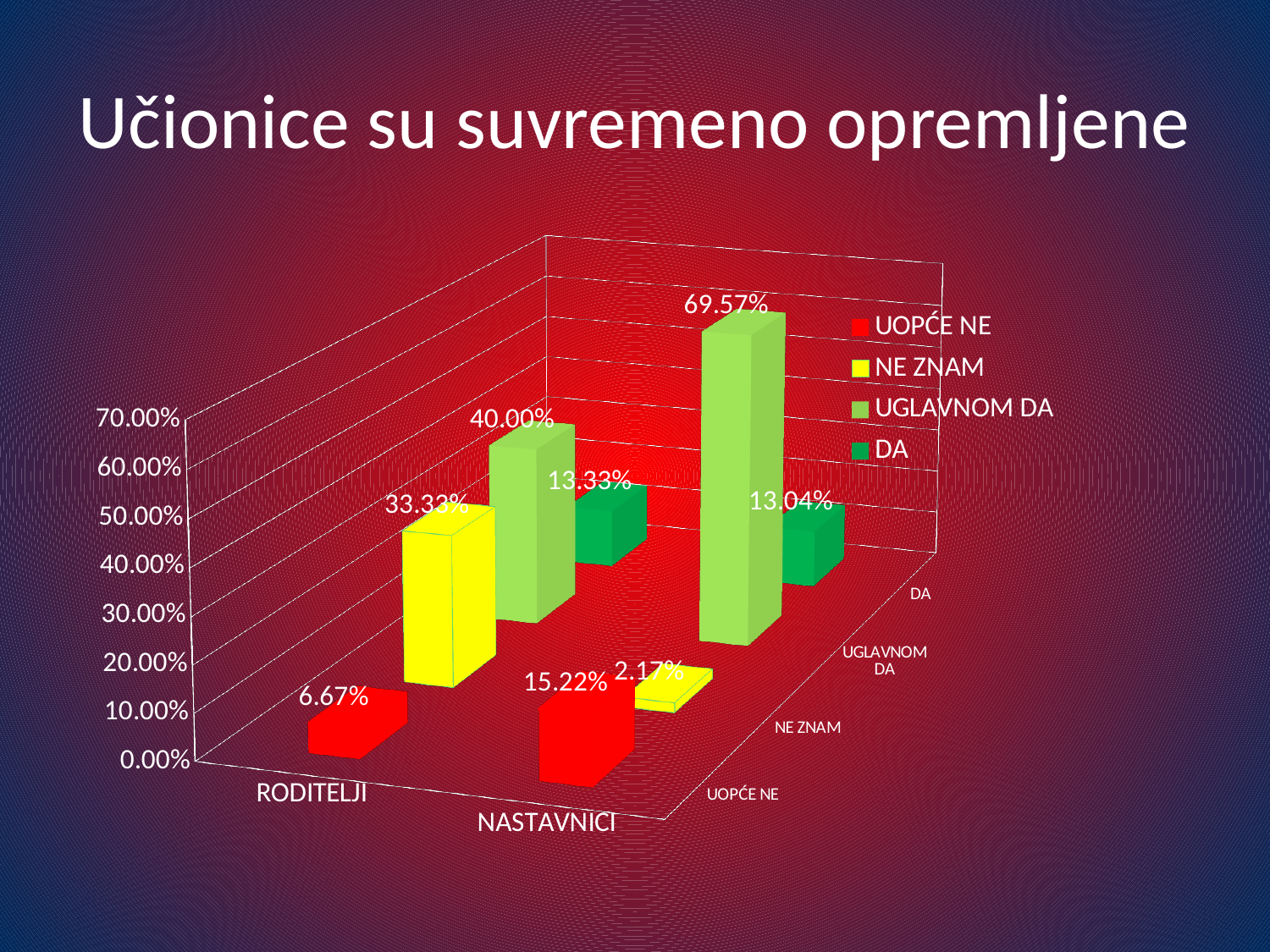
How many categories are shown on the x axis? 2 Which series has the highest value for NASTAVNICI? UGLAVNOM DA Which is larger: NE ZNAM for RODITELJI or NE ZNAM for NASTAVNICI? NE ZNAM for RODITELJI What is the value for UOPĆE NE for NASTAVNICI? 15.22% What kind of chart is shown on the slide? Bar chart What is the value for NE ZNAM for RODITELJI? 33.33% What is the difference between the UGLAVNOM DA values for NASTAVNICI and RODITELJI? 29.57% What is the value for UGLAVNOM DA for NASTAVNICI? 69.57% Which series has the lowest value for RODITELJI? UOPĆE NE What is the value for DA for RODITELJI? 13.33% What is the title of the slide? Učionice su suvremeno opremljene How many series does the legend list? 4